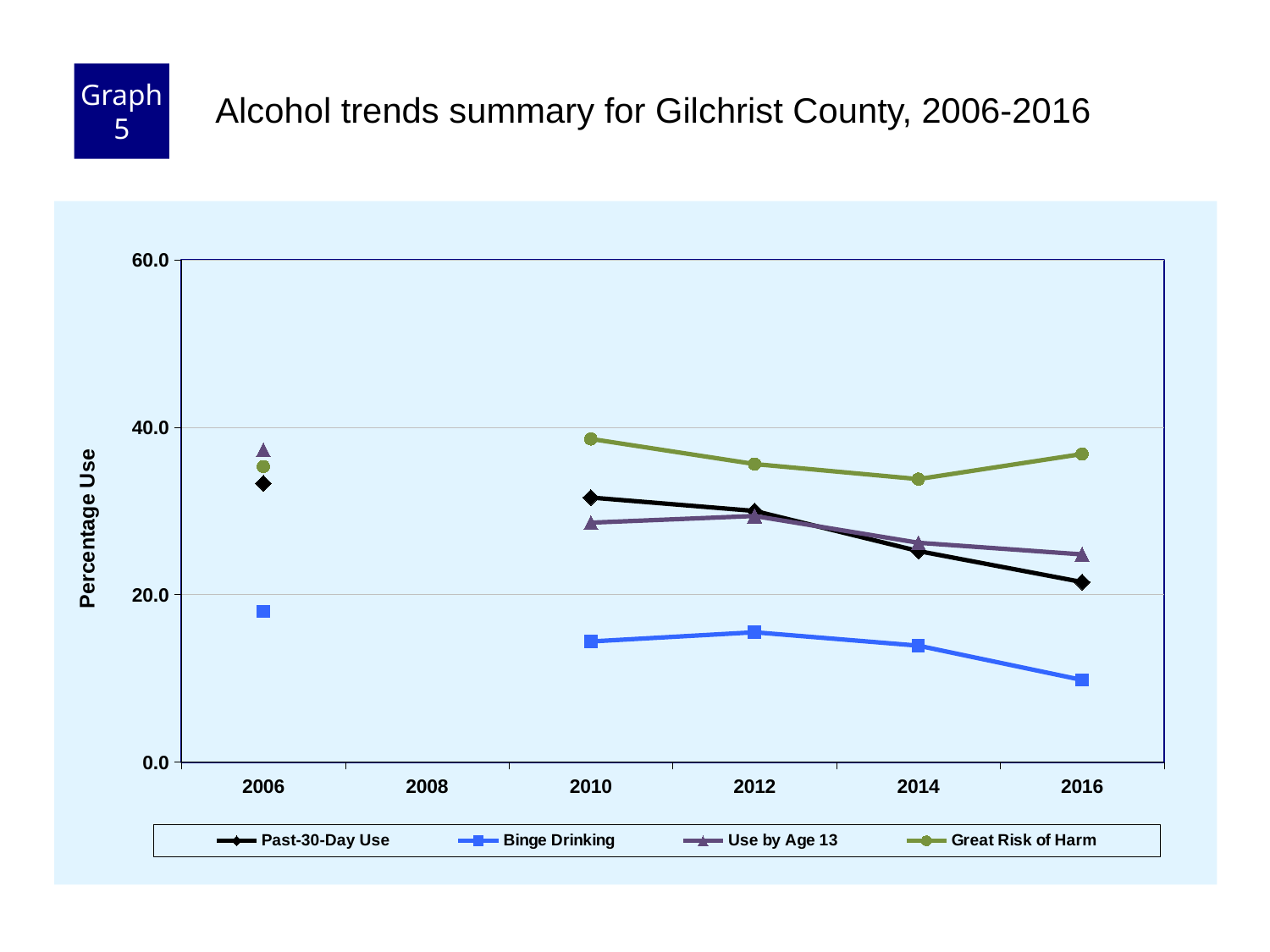
What kind of chart is shown on the slide? line chart What is the label on the y axis? Percentage Use Does the Past-30-Day Use line rise or fall from 2010 to 2016? fall In 2016, which is larger: Great Risk of Harm or Past-30-Day Use? Great Risk of Harm Is the value for Past-30-Day Use in 2010 greater or less than 20.0? greater Which series has the lowest value in 2016? Binge Drinking How many series does the legend list? 4 Does the Binge Drinking line rise or fall from 2012 to 2016? fall How many year labels are shown on the x axis? 6 Is the value for Great Risk of Harm in 2010 greater or less than 40.0? less Which series has the highest value in 2010? Great Risk of Harm Is the value for Binge Drinking in 2016 greater or less than 20.0? less